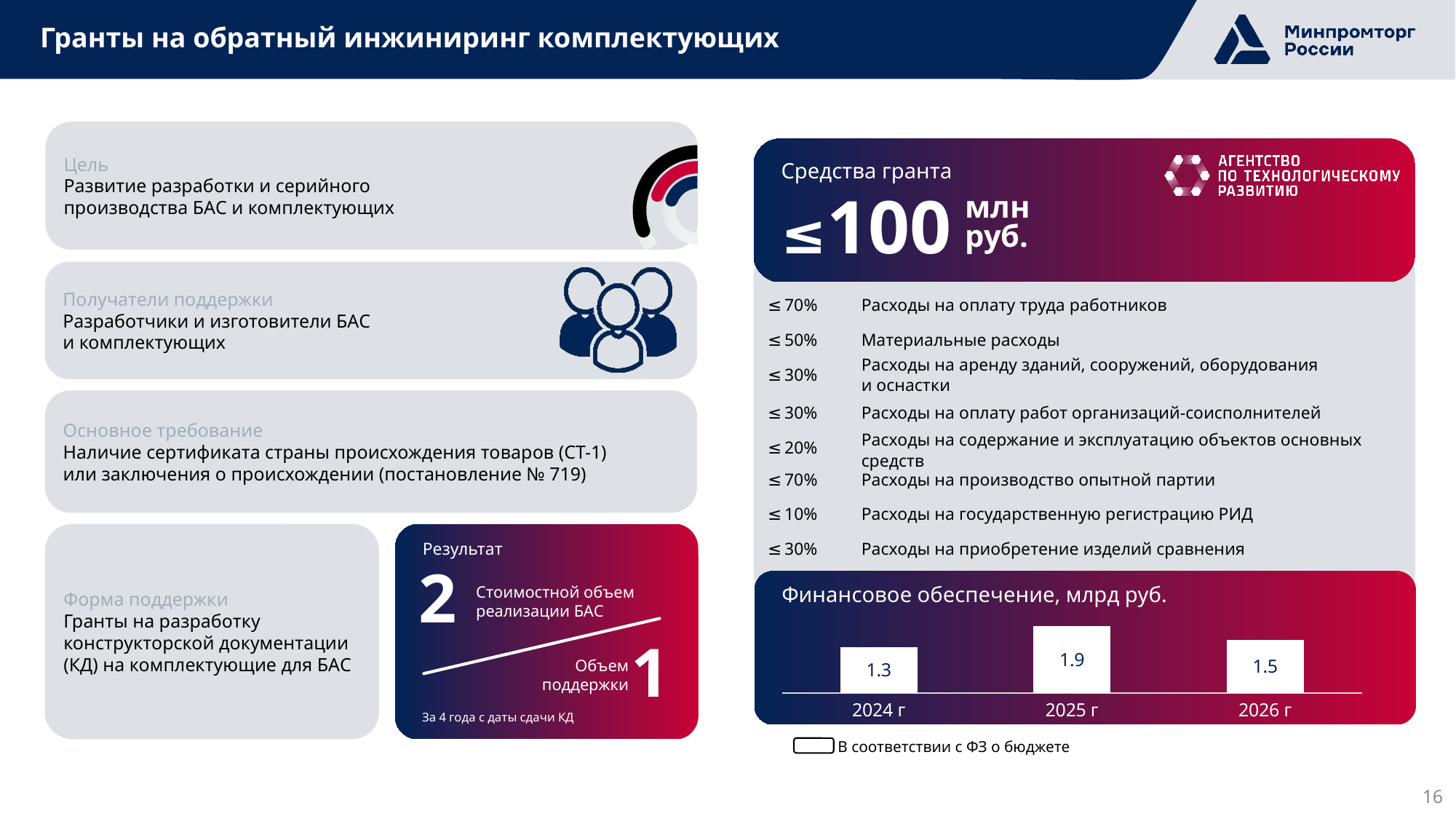
Which year has the lowest value in the chart "Финансовое обеспечение, млрд руб."? 2024 г What kind of chart is "Финансовое обеспечение, млрд руб."? bar chart How many years are shown in the chart "Финансовое обеспечение, млрд руб."? 3 Which year has the highest value in the chart "Финансовое обеспечение, млрд руб."? 2025 г What is the legend entry of the chart "Финансовое обеспечение, млрд руб."? В соответствии с ФЗ о бюджете What is the difference between the values for 2025 г and 2026 г in the chart "Финансовое обеспечение, млрд руб."? 0.4 How many series does the legend of the chart "Финансовое обеспечение, млрд руб." list? 1 In the chart "Финансовое обеспечение, млрд руб.", which is larger: the value for 2026 г or the value for 2024 г? 2026 г What is the value for 2026 г in the chart "Финансовое обеспечение, млрд руб."? 1.5 What is the value for 2025 г in the chart "Финансовое обеспечение, млрд руб."? 1.9 What is the value for 2024 г in the chart "Финансовое обеспечение, млрд руб."? 1.3 What is the difference between the values for 2025 г and 2024 г in the chart "Финансовое обеспечение, млрд руб."? 0.6